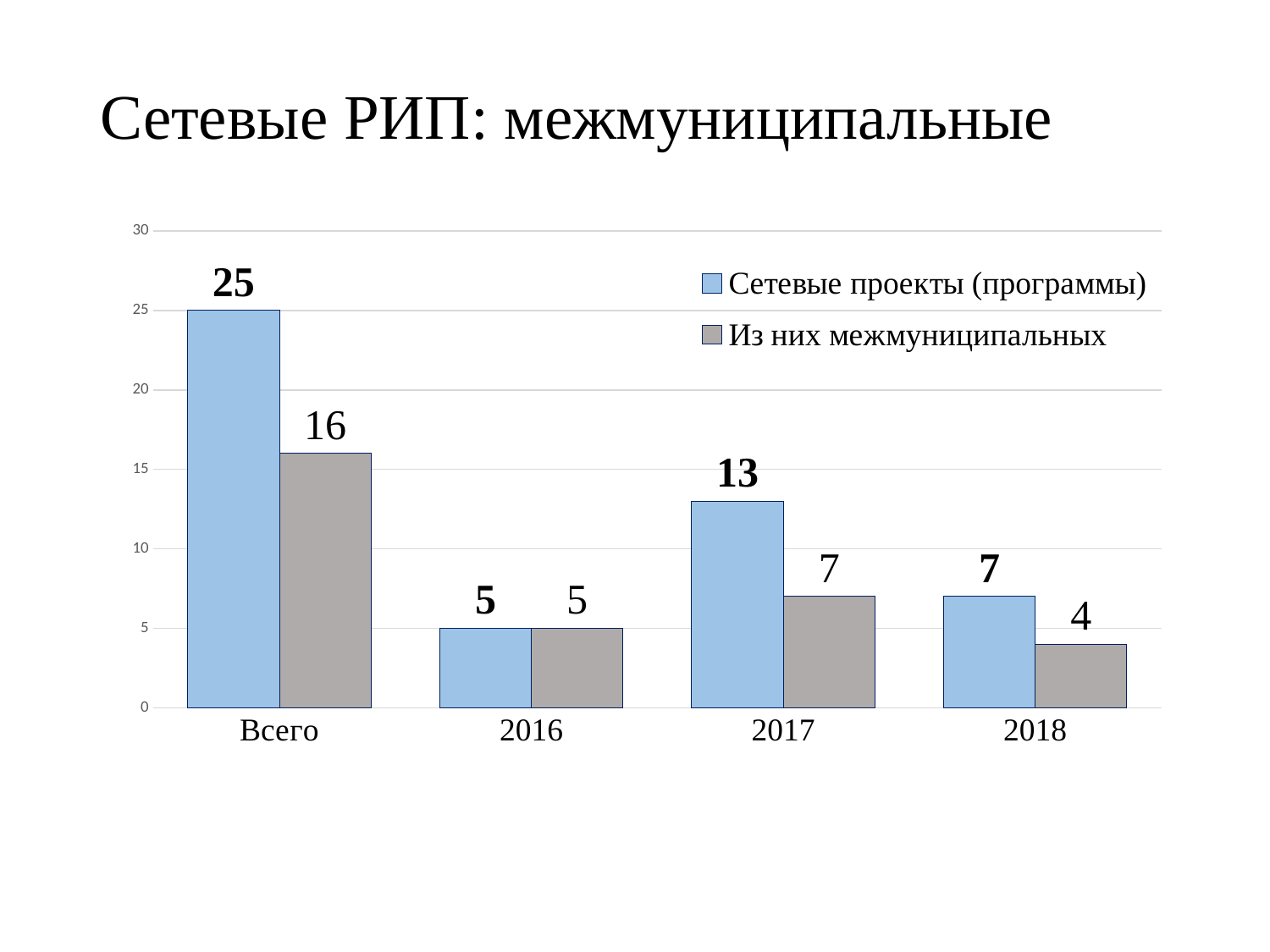
How many series does the legend list? 2 What is the difference between 'Сетевые проекты (программы)' and 'Из них межмуниципальных' for 'Всего'? 9 Which category has the lowest value for 'Из них межмуниципальных'? 2018 What is the title of the slide? Сетевые РИП: межмуниципальные What kind of chart is shown on the slide? bar chart What is the value of 'Сетевые проекты (программы)' for 'Всего'? 25 How many categories are shown on the x axis? 4 Which year (excluding 'Всего') has the highest value for 'Сетевые проекты (программы)'? 2017 What is the value of 'Из них межмуниципальных' for 2018? 4 What is the value of 'Сетевые проекты (программы)' for 2016? 5 What is the value of 'Из них межмуниципальных' for 2017? 7 Which is larger for 2017: 'Сетевые проекты (программы)' or 'Из них межмуниципальных'? Сетевые проекты (программы)